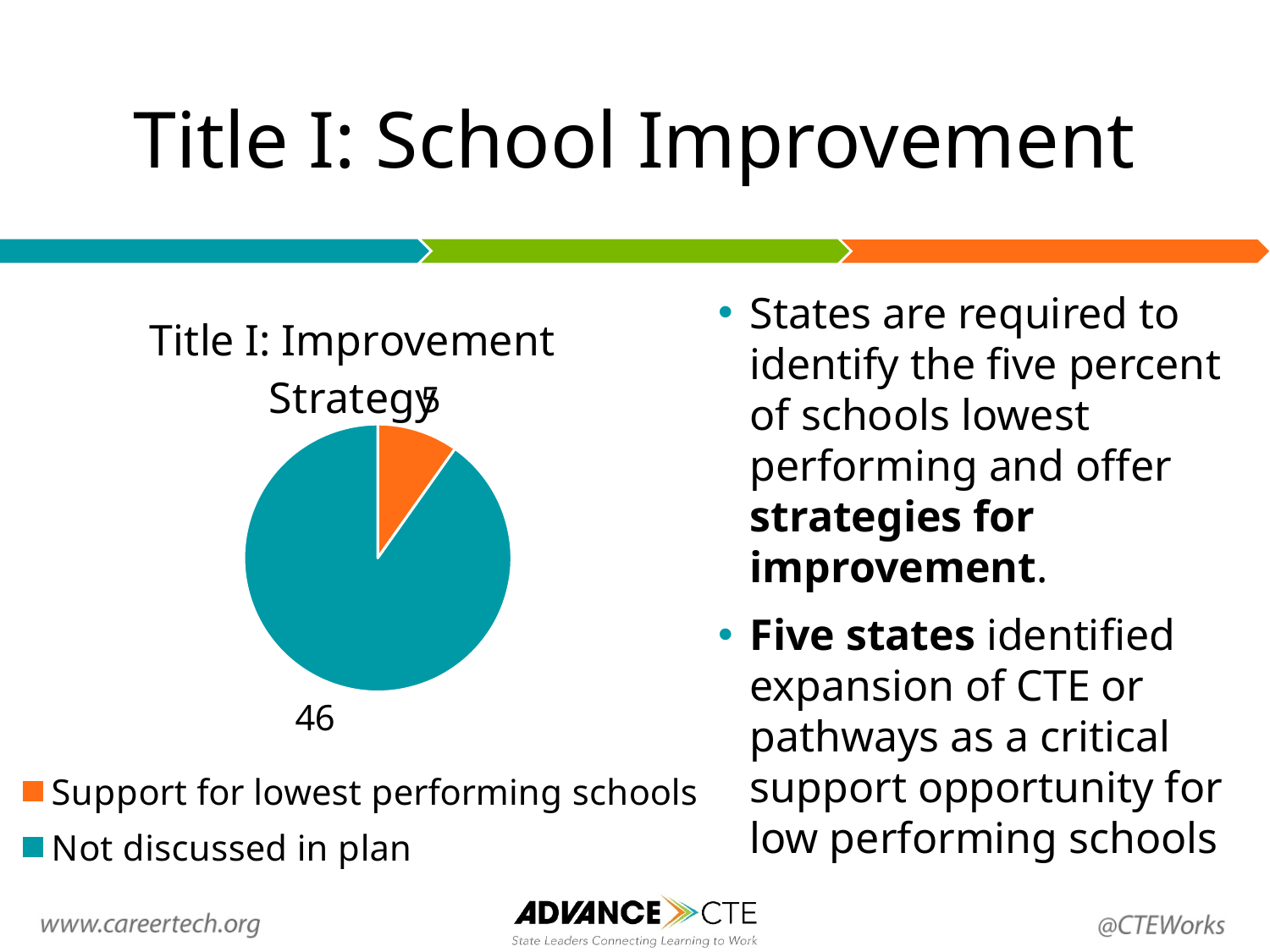
Which colour represents "Support for lowest performing schools" in the pie chart? orange Which is larger: "Support for lowest performing schools" or "Not discussed in plan"? Not discussed in plan How many slices does the pie chart have? 2 Is the value for "Not discussed in plan" greater or less than 40? greater What is the value for "Not discussed in plan"? 46 How many entries does the chart legend list? 2 Which category has the largest slice of the pie? Not discussed in plan Which category has the smallest slice of the pie? Support for lowest performing schools What is the title of the chart? Title I: Improvement Strategy What kind of chart is shown on the slide? pie chart